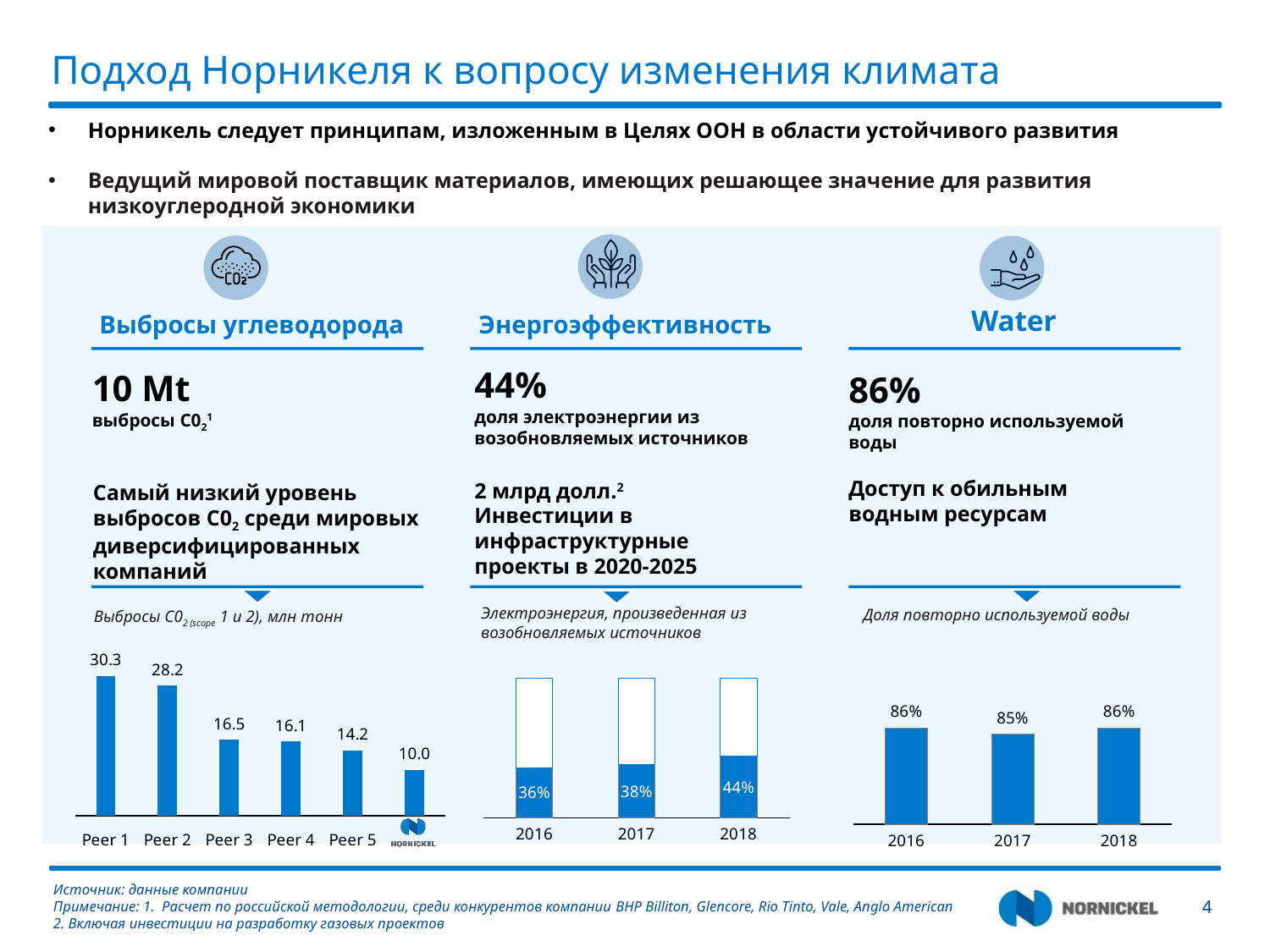
In the middle chart (electricity produced from renewable sources), what is the value for 2018? 44% In the left chart (CO2 emissions, scope 1 and 2, mln tonnes), what is the difference between Peer 1 and Peer 2? 2.1 In the right chart (share of reused water), which year has the lowest value? 2017 What type of chart is the right chart (share of reused water)? bar chart In the left chart (CO2 emissions, scope 1 and 2, mln tonnes), which category has the lowest value? Nornickel In the left chart (CO2 emissions, scope 1 and 2, mln tonnes), what is the value for Peer 4? 16.1 In the left chart (CO2 emissions, scope 1 and 2, mln tonnes), which category has the highest value? Peer 1 In the right chart (share of reused water), what is the value for 2017? 85% In the left chart (CO2 emissions, scope 1 and 2, mln tonnes), how many bars are shown? 6 In the middle chart (electricity produced from renewable sources), do the values rise or fall from 2016 to 2018? rise In the middle chart (electricity produced from renewable sources), what is the value for 2016? 36% In the left chart (CO2 emissions, scope 1 and 2, mln tonnes), what is the value for Peer 1? 30.3